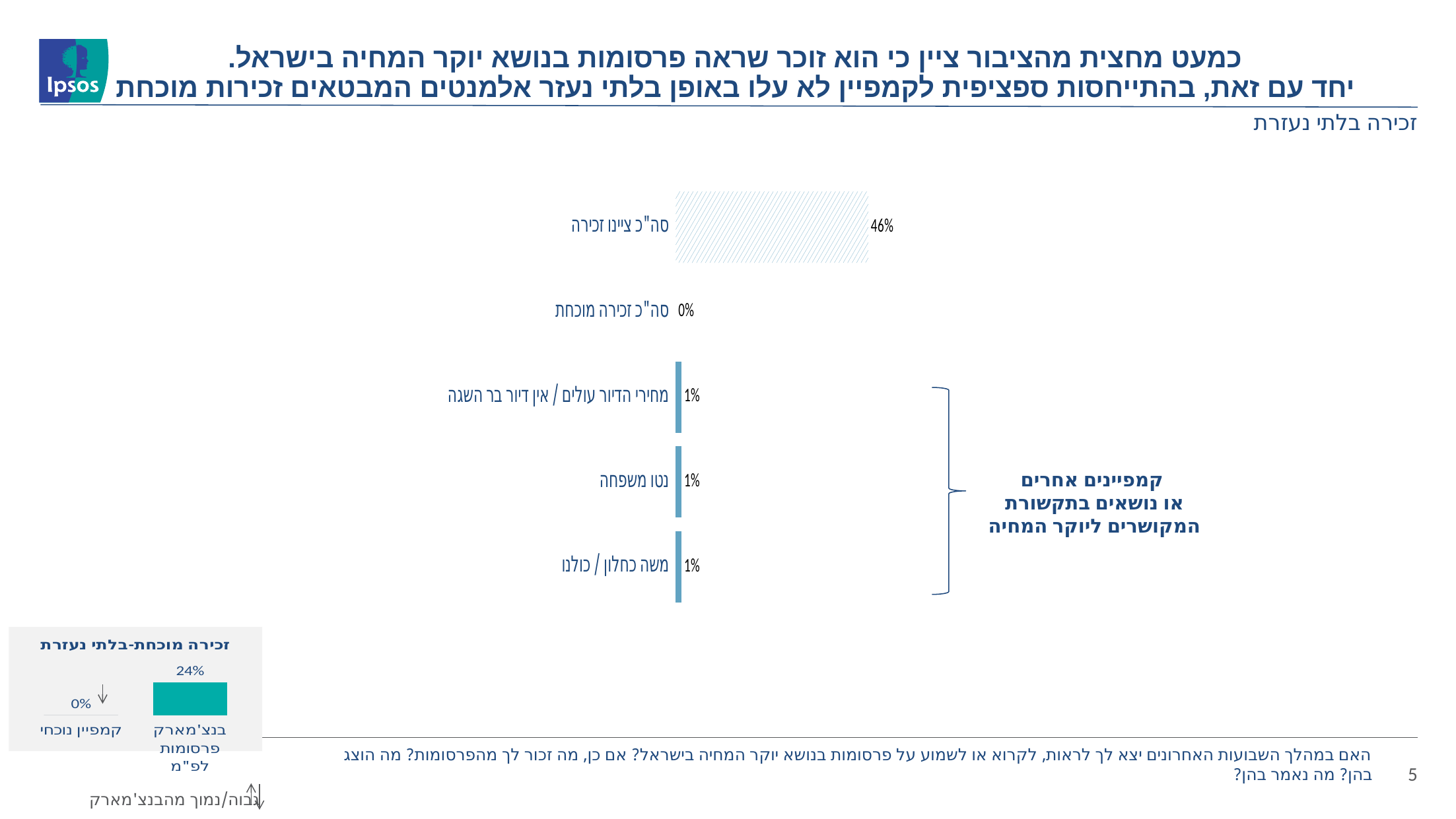
In the main chart, which category has the lowest value? סה"כ זכירה מוכחת In the main chart, how many categories are shown? 5 In the main chart, what is the value for מחירי הדיור עולים / אין דיור בר השגה? 1% In the main chart, what is the difference between סה"כ ציינו זכירה and נטו משפחה? 45% In the main chart, what is the value for סה"כ ציינו זכירה? 46% In the small chart at the bottom left (זכירה מוכחת-בלתי נעזרת), what is the value for קמפיין נוכחי? 0% In the main chart, what is the value for משה כחלון / כולנו? 1% In the main chart, what is the value for סה"כ זכירה מוכחת? 0% In the small chart at the bottom left, which is larger: בנצ'מארק פרסומות לפ"מ or קמפיין נוכחי? בנצ'מארק פרסומות לפ"מ In the small chart at the bottom left (זכירה מוכחת-בלתי נעזרת), what is the value for בנצ'מארק פרסומות לפ"מ? 24% What type of chart is the main chart on the slide? bar chart In the main chart, which category has the highest value? סה"כ ציינו זכירה